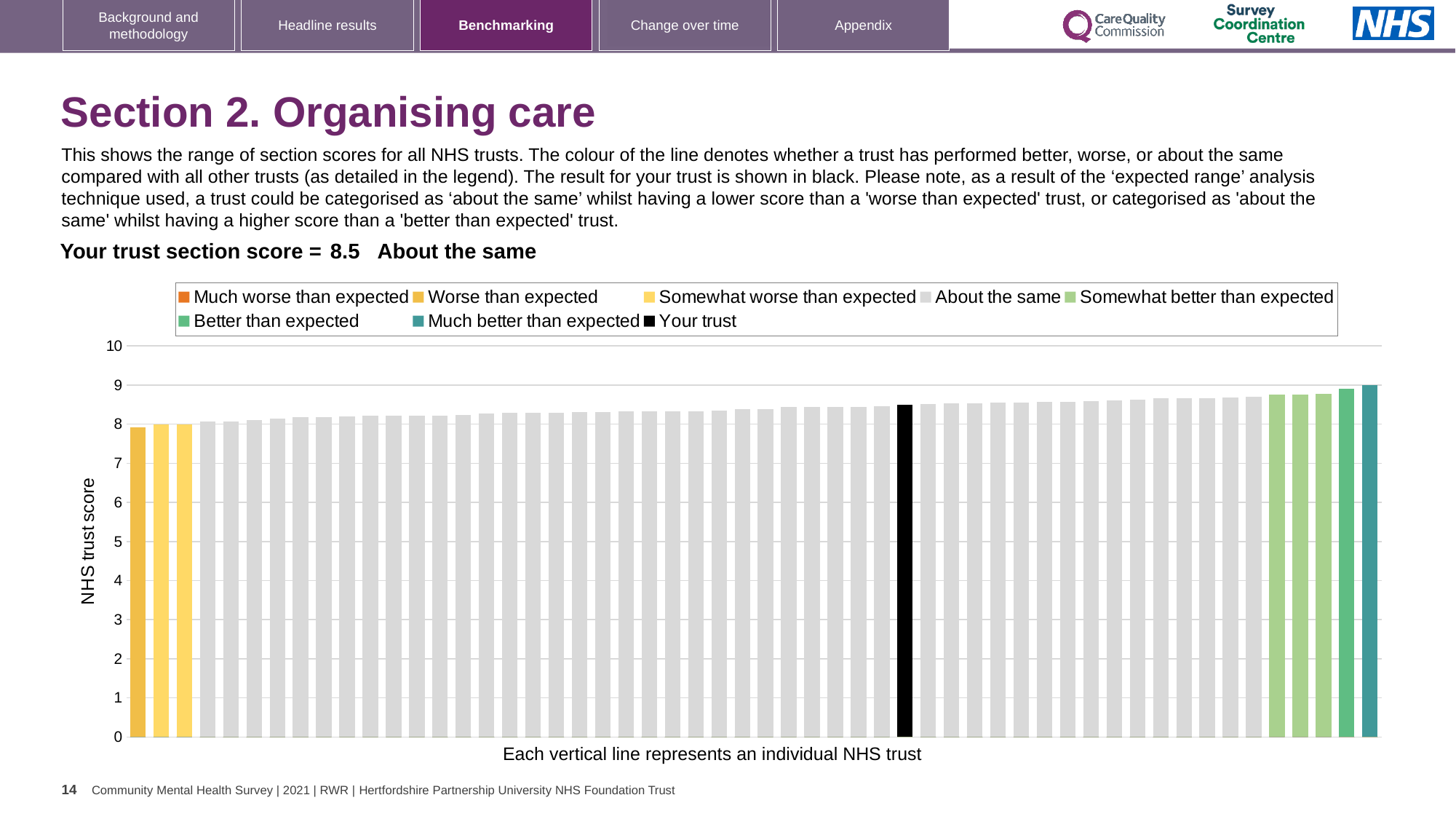
Is the value for your trust greater or less than 8? greater Which is larger: the value for your trust or the value of the rightmost bar? the rightmost bar Which legend category does the shortest bar on the chart belong to? Worse than expected Which category does your trust fall into according to the slide? About the same Which legend category does the tallest bar on the chart belong to? Much better than expected What is the section score for your trust shown on the slide? 8.5 Is the value for the tallest bar greater or less than 8? greater Is the value for the shortest bar greater or less than 9? less What is the label on the vertical axis of the chart? NHS trust score What kind of chart is shown on the slide? bar chart Do the bar values rise or fall from left to right along the x axis? rise How many entries does the chart legend list? 8